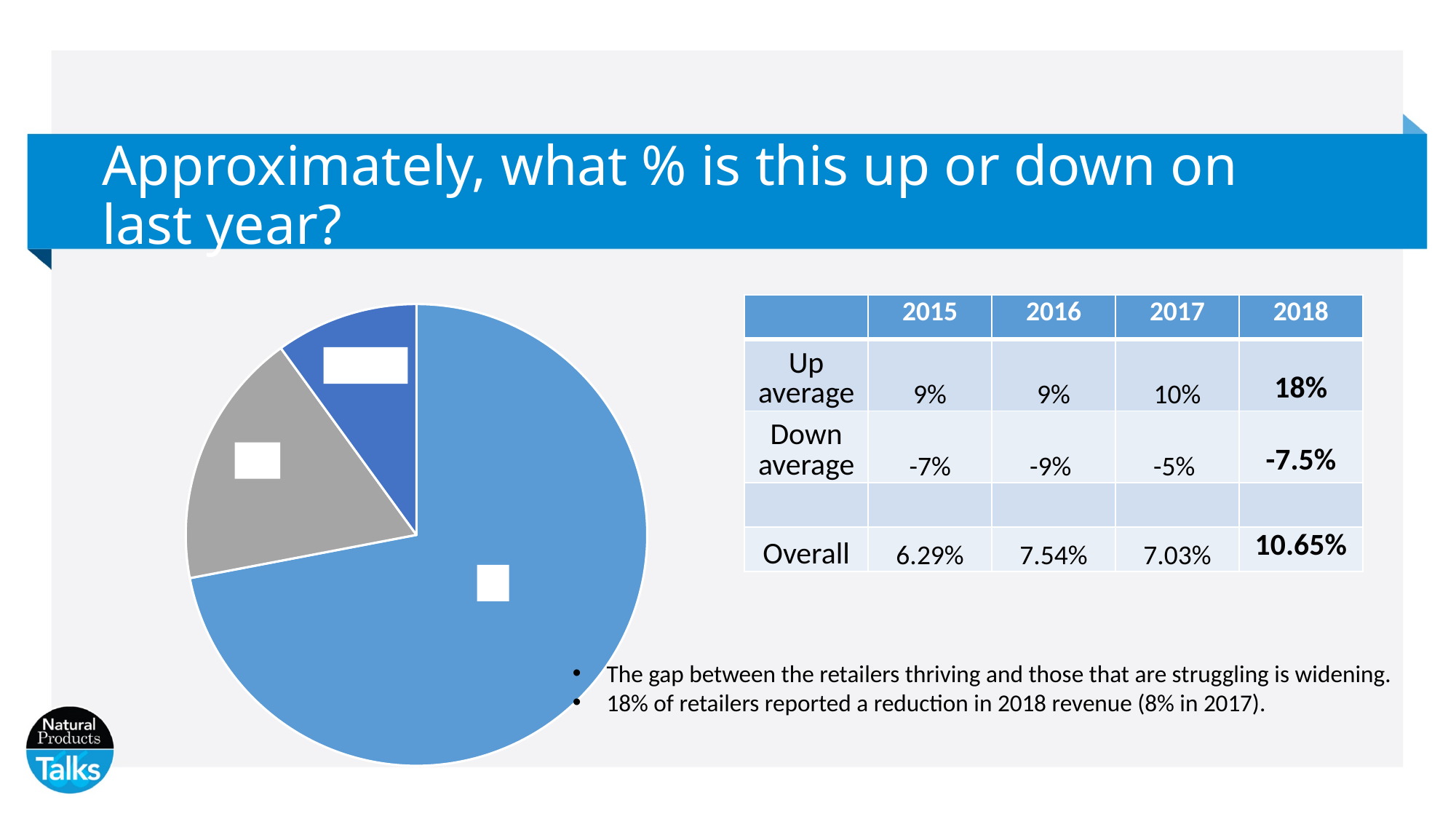
Is the grey slice of the pie chart larger or smaller than the dark blue slice? larger Is the light blue slice of the pie chart larger or smaller than the grey slice? larger Which colour slice is the largest in the pie chart? light blue What kind of chart is shown on the slide? pie chart Which colour slice is the smallest in the pie chart? dark blue Does the pie chart display a legend? No Does the largest slice of the pie chart take up more or less than half of the pie? more How many slices does the pie chart have? 3